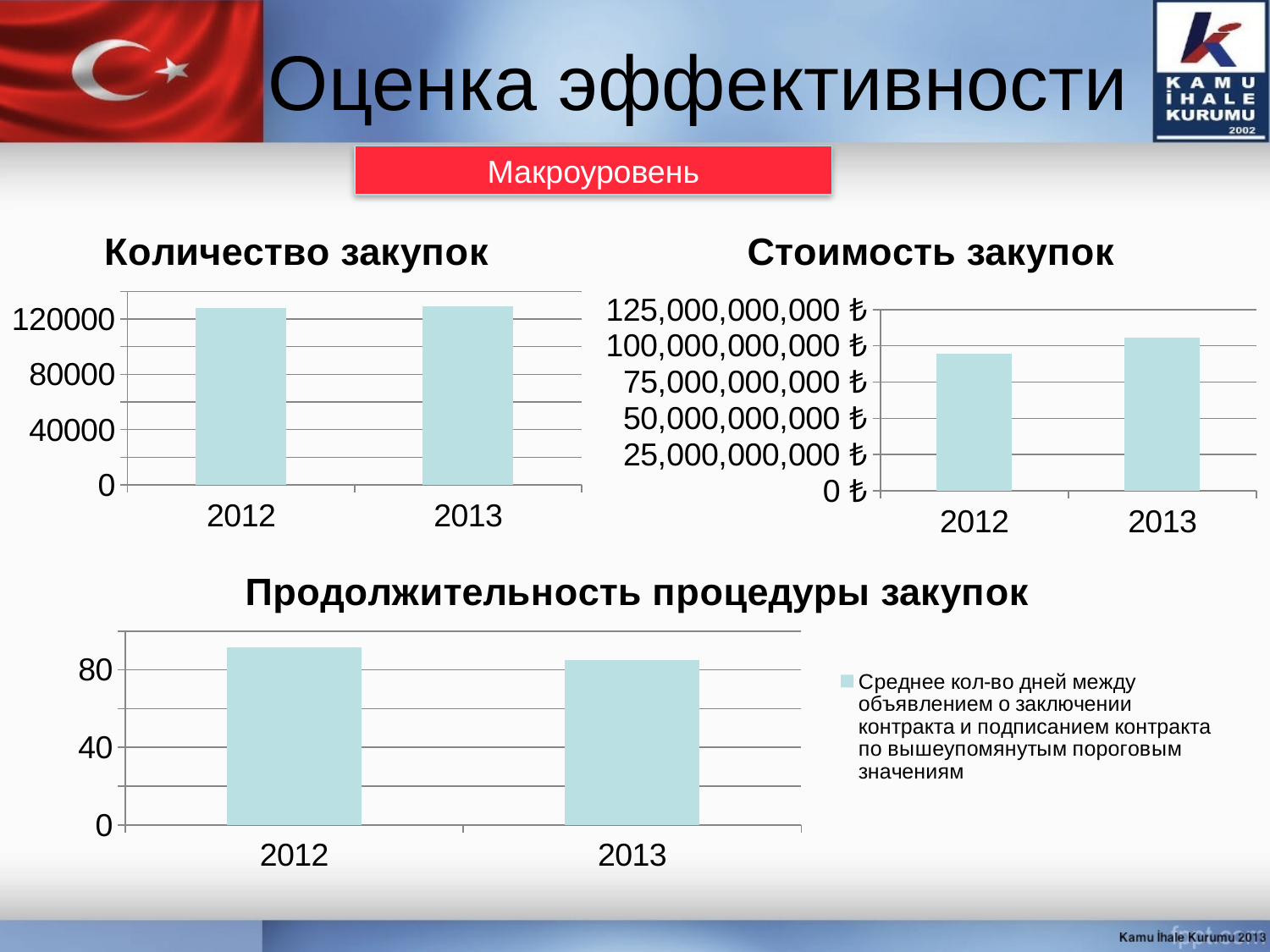
In the "Количество закупок" chart, is the value for 2012 greater or less than 120000? greater What kind of chart is the "Количество закупок" chart? bar chart How many categories are shown on the x axis of the "Стоимость закупок" chart? 2 In the "Стоимость закупок" chart, do the values rise or fall from 2012 to 2013? rise How many charts are shown on the slide? 3 In the "Стоимость закупок" chart, is the value for 2013 greater or less than 100,000,000,000 ₺? greater In the "Количество закупок" chart, is the value for 2013 greater or less than 80000? greater In the "Стоимость закупок" chart, which year has the higher value, 2012 or 2013? 2013 In the "Продолжительность процедуры закупок" chart, which year has the higher value, 2012 or 2013? 2012 In the "Продолжительность процедуры закупок" chart, do the values rise or fall from 2012 to 2013? fall